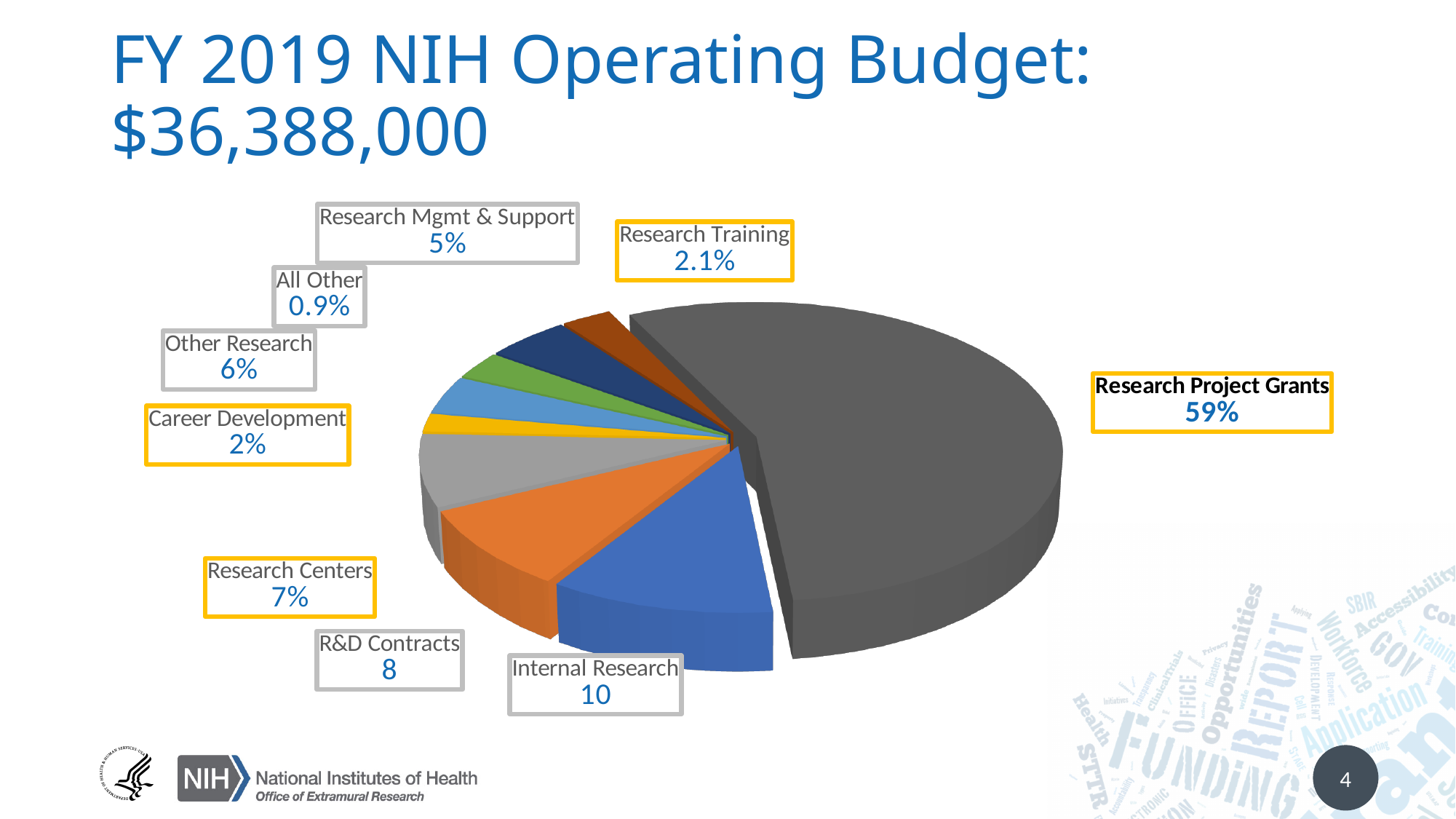
What value is shown for Research Training? 2.1% What value is labelled for Internal Research? 10 How many categories are shown in the pie chart? 9 What kind of chart is shown on the slide? pie chart What value is labelled for Research Centers? 7% What value is shown for All Other? 0.9% What share of the FY 2019 NIH operating budget goes to Research Project Grants? 59% What total operating budget is stated in the slide title? $36,388,000 Which category has the largest slice of the pie? Research Project Grants What is the difference between the Research Project Grants share and the Research Centers share? 52%